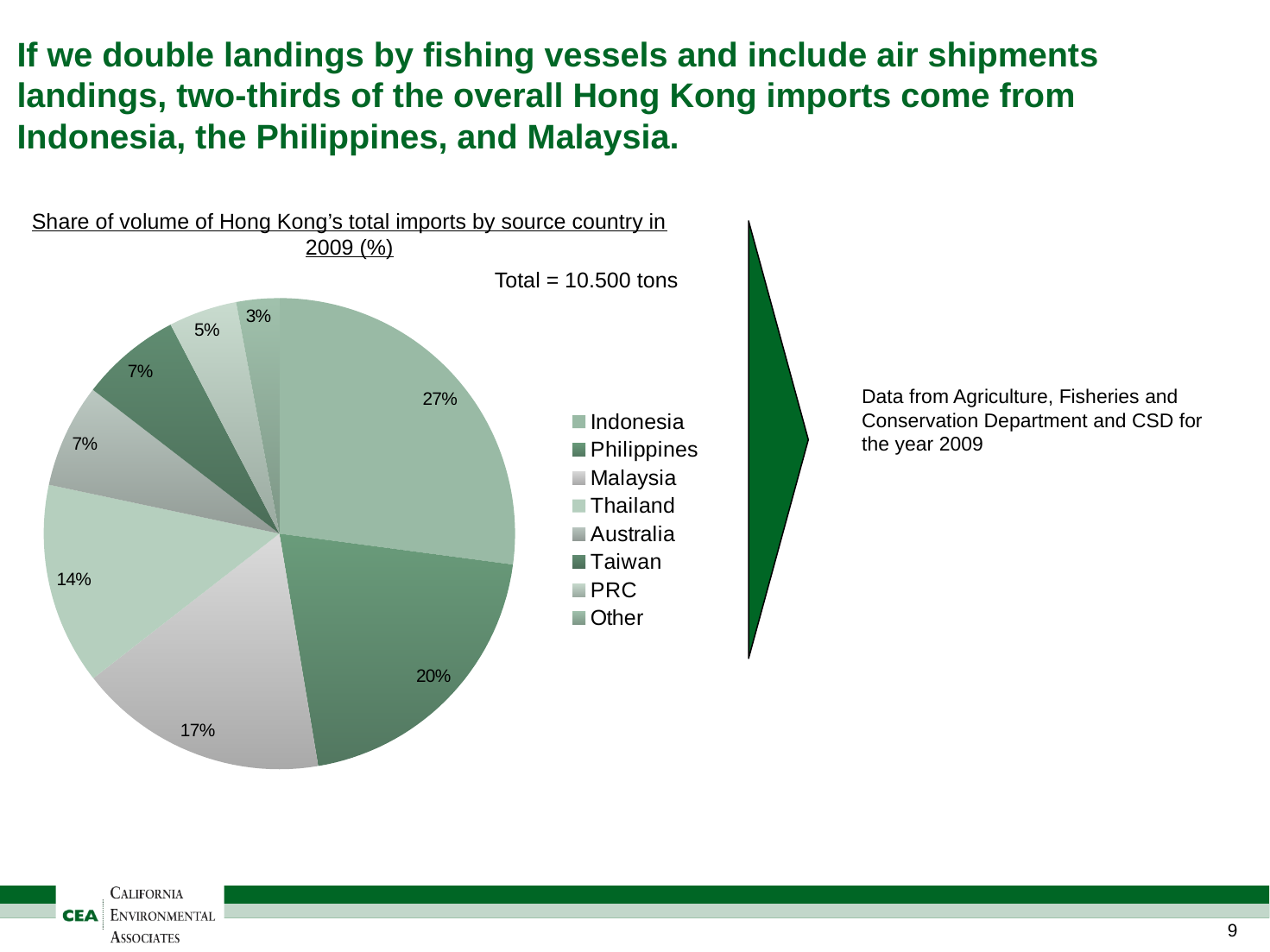
Which has a larger share, Malaysia or Thailand? Malaysia What share of imports came from Thailand? 14% How many percentage points larger is Indonesia's share than the Philippines' share? 7 What share of the pie does the Philippines account for? 20% Which source country has the largest share of Hong Kong's imports? Indonesia Which category has the smallest slice of the pie? Other What share is shown for PRC? 5% How many source categories does the pie chart show? 8 What share of Hong Kong's total imports in 2009 came from Indonesia? 27% What total volume of imports is stated above the pie chart? 10.500 tons What type of chart is shown on the slide? Pie chart What is the share shown for Malaysia? 17%